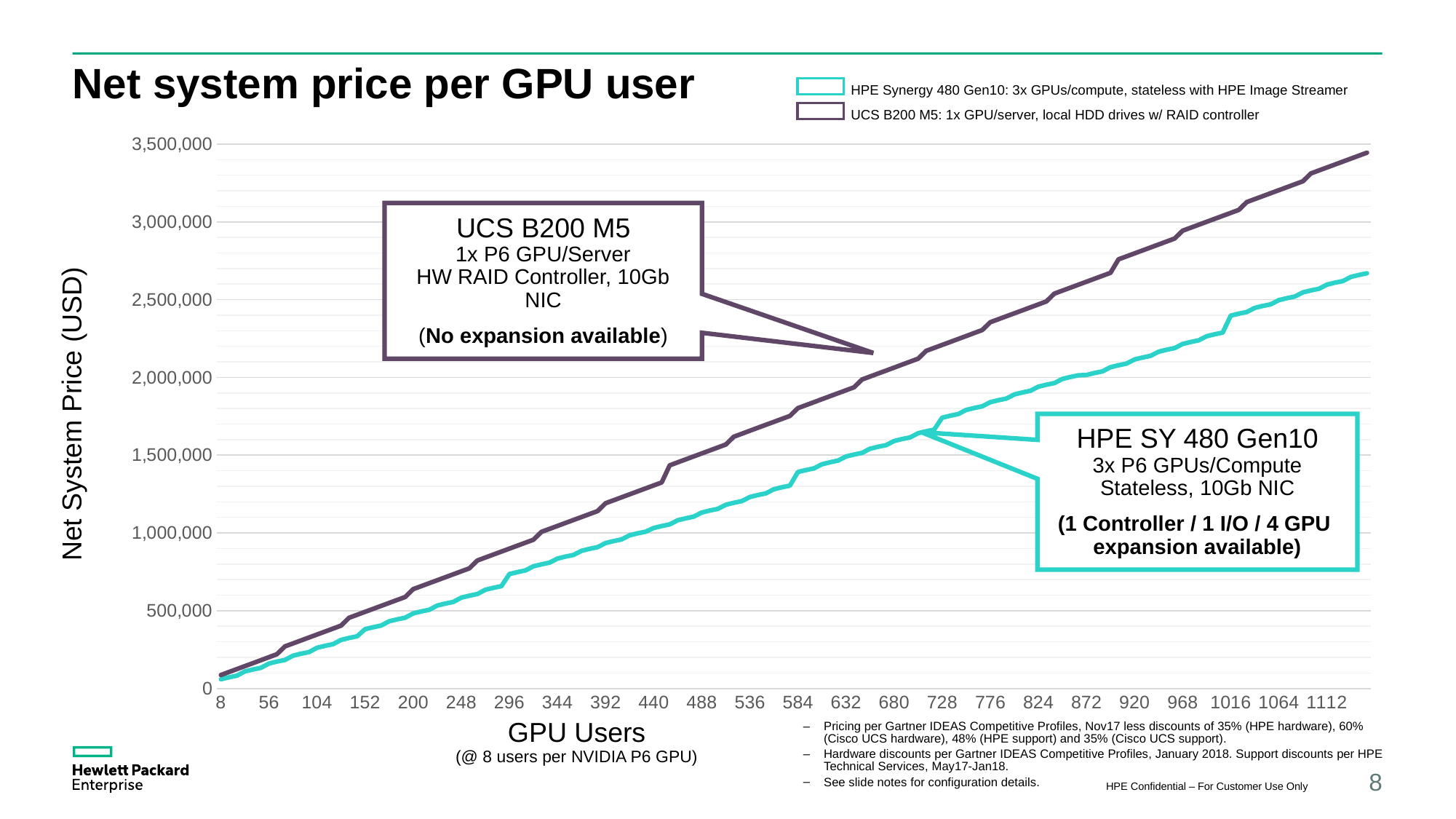
Is the value for UCS B200 M5 at 584 GPU users greater or less than 1,500,000? greater How many series does the legend list? 2 Is the value for UCS B200 M5 at 1112 GPU users greater or less than 3,000,000? greater What is the label of the y axis? Net System Price (USD) Is the value for UCS B200 M5 at 248 GPU users greater or less than 1,000,000? less Which series has the higher net system price at 680 GPU users? UCS B200 M5 What kind of chart is shown on the slide? line chart Do the values for the UCS B200 M5 series rise or fall as the number of GPU users increases? rise Which series reaches the highest net system price on the chart? UCS B200 M5 What is the title of the chart? Net system price per GPU user